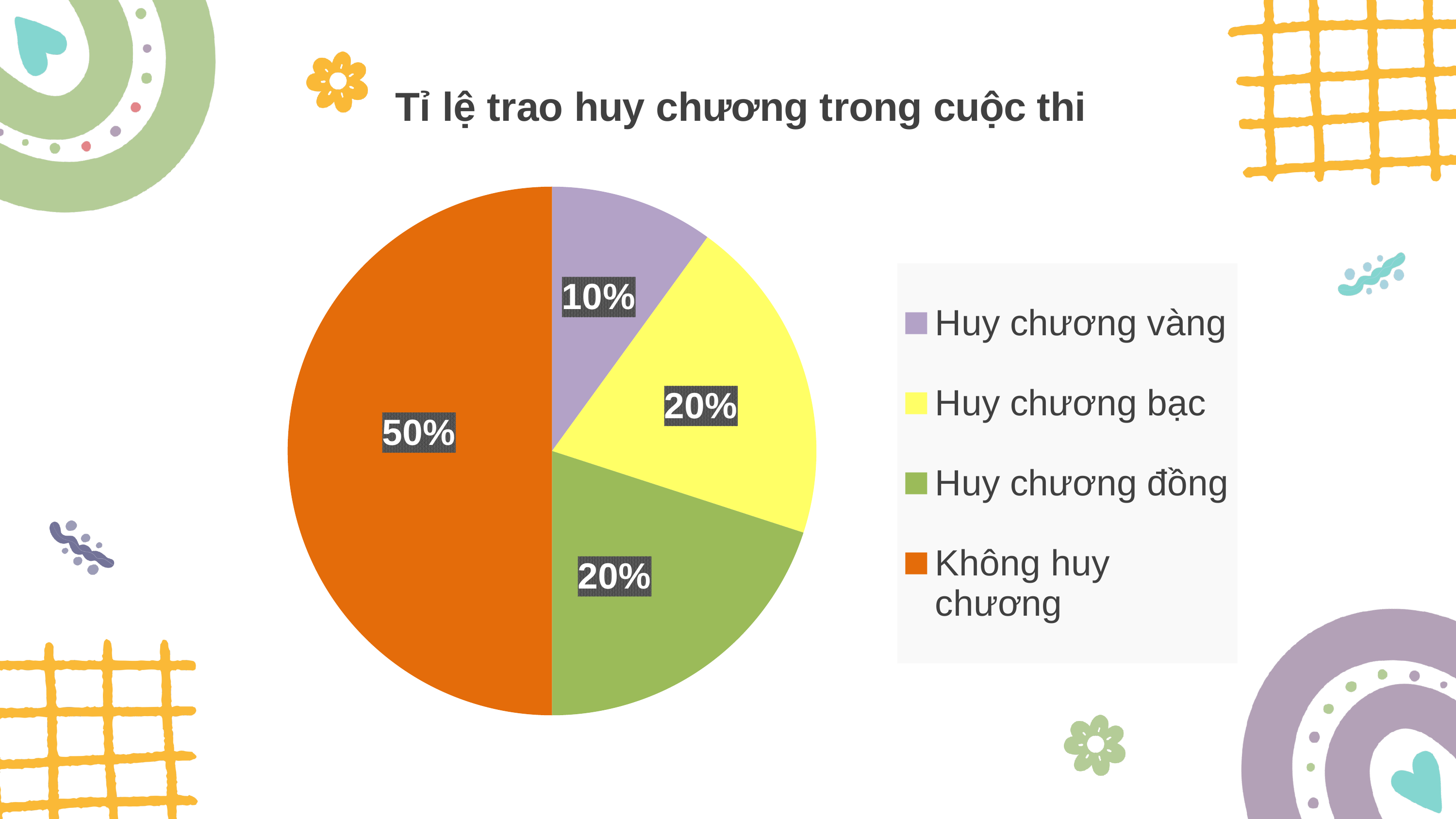
Which category has the smallest share of the pie? Huy chương vàng What kind of chart is shown on the slide? pie chart What colour is the slice for Không huy chương? orange What percentage is shown for Không huy chương? 50% What percentage is shown for Huy chương đồng? 20% Which is larger, the share for Huy chương bạc or the share for Huy chương vàng? Huy chương bạc Which category has the largest share of the pie? Không huy chương What is the title of the chart? Tỉ lệ trao huy chương trong cuộc thi What percentage is shown for Huy chương vàng? 10% What percentage is shown for Huy chương bạc? 20% How many categories does the legend list? 4 What is the difference between the share for Không huy chương and the share for Huy chương vàng? 40%